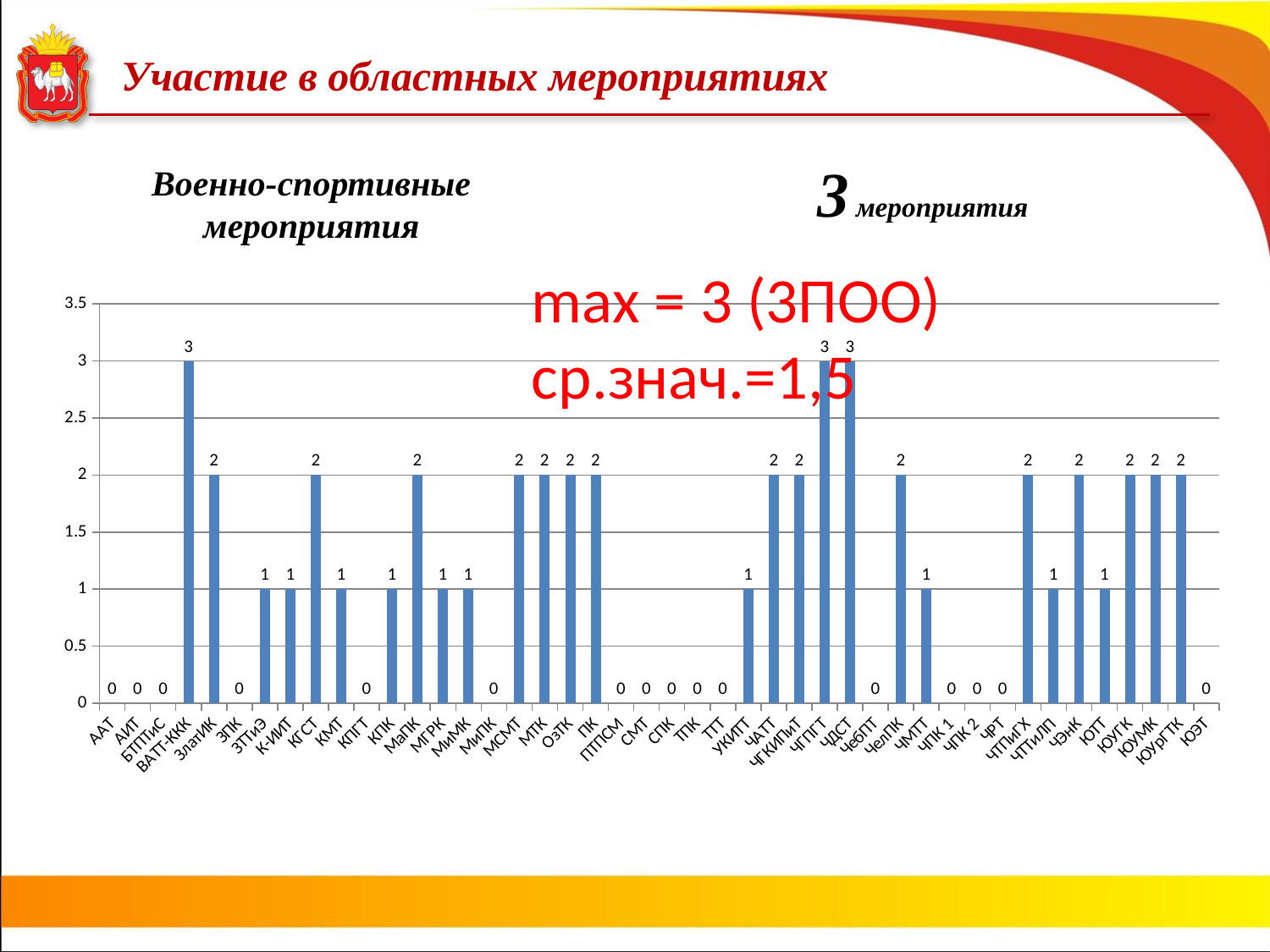
What average value (ср.знач.) is written on the chart? 1,5 What is the value for КМТ? 1 What is the highest value on the y axis? 3.5 What is the difference between the values for ВАТТ-ККК and ЗТТиЭ? 2 What is the value for ЗлатИК? 2 Which is larger, the value for КГСТ or the value for КМТ? КГСТ What is the value for ЧелПК? 2 Which is larger, the value for ЧГПГТ or the value for ЧМТТ? ЧГПГТ What is the value for ЮЭТ? 0 What is the value for ЧДСТ? 3 What is the value for ВАТТ-ККК? 3 What kind of chart is shown on the slide? Bar chart